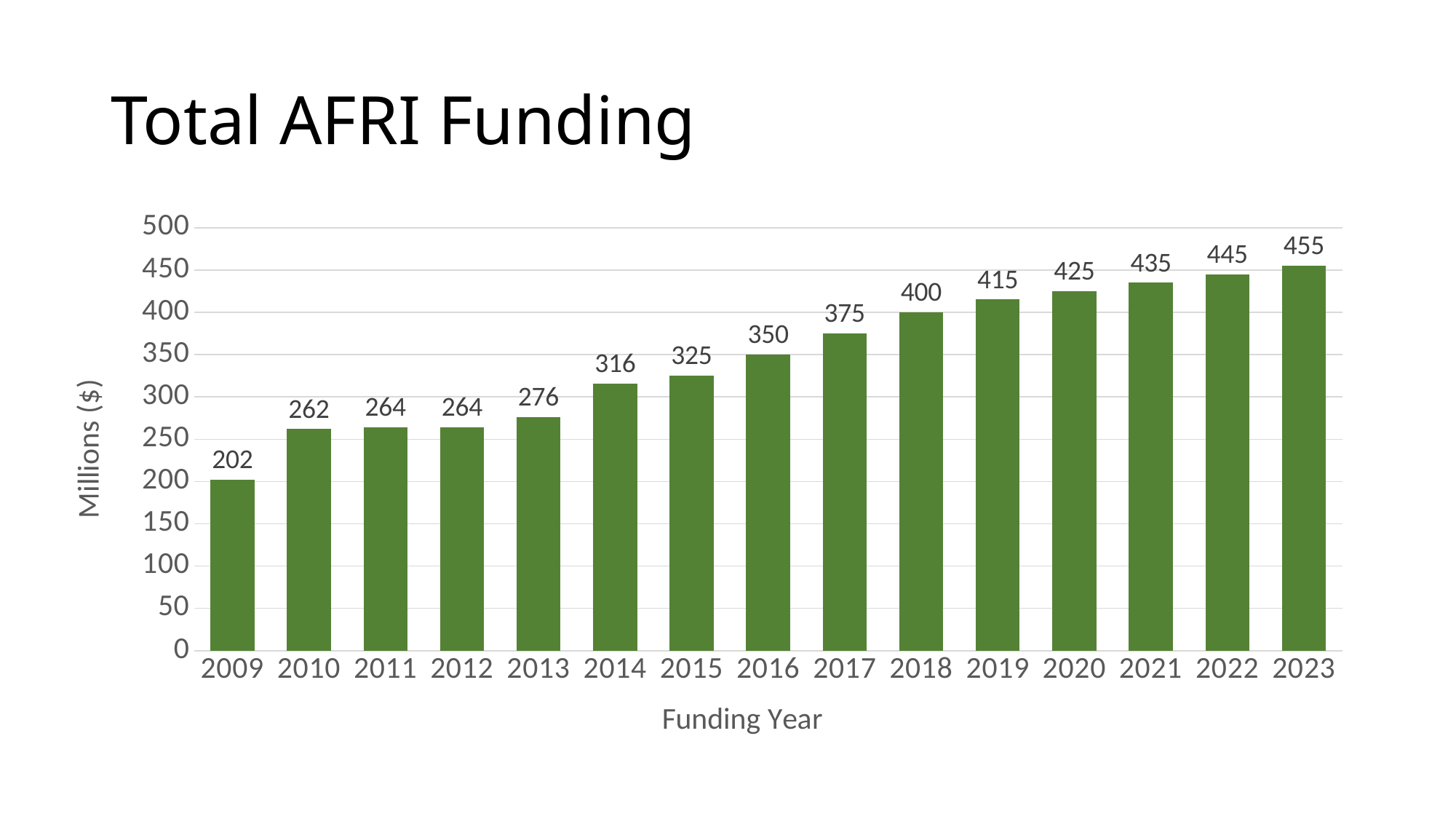
What is the total AFRI funding for 2014? 316 What is the label of the vertical axis? Millions ($) What is the total AFRI funding for 2009? 202 What kind of chart is shown on the slide? Bar chart Which year has higher funding, 2013 or 2015? 2015 What is the difference between the funding in 2017 and the funding in 2016? 25 Which funding year has the highest total AFRI funding? 2023 What is the difference between the funding in 2023 and the funding in 2009? 253 Do the funding values generally rise or fall from 2009 to 2023? Rise How many funding years are shown on the chart? 15 What is the total AFRI funding for 2018? 400 Which funding year has the lowest total AFRI funding? 2009